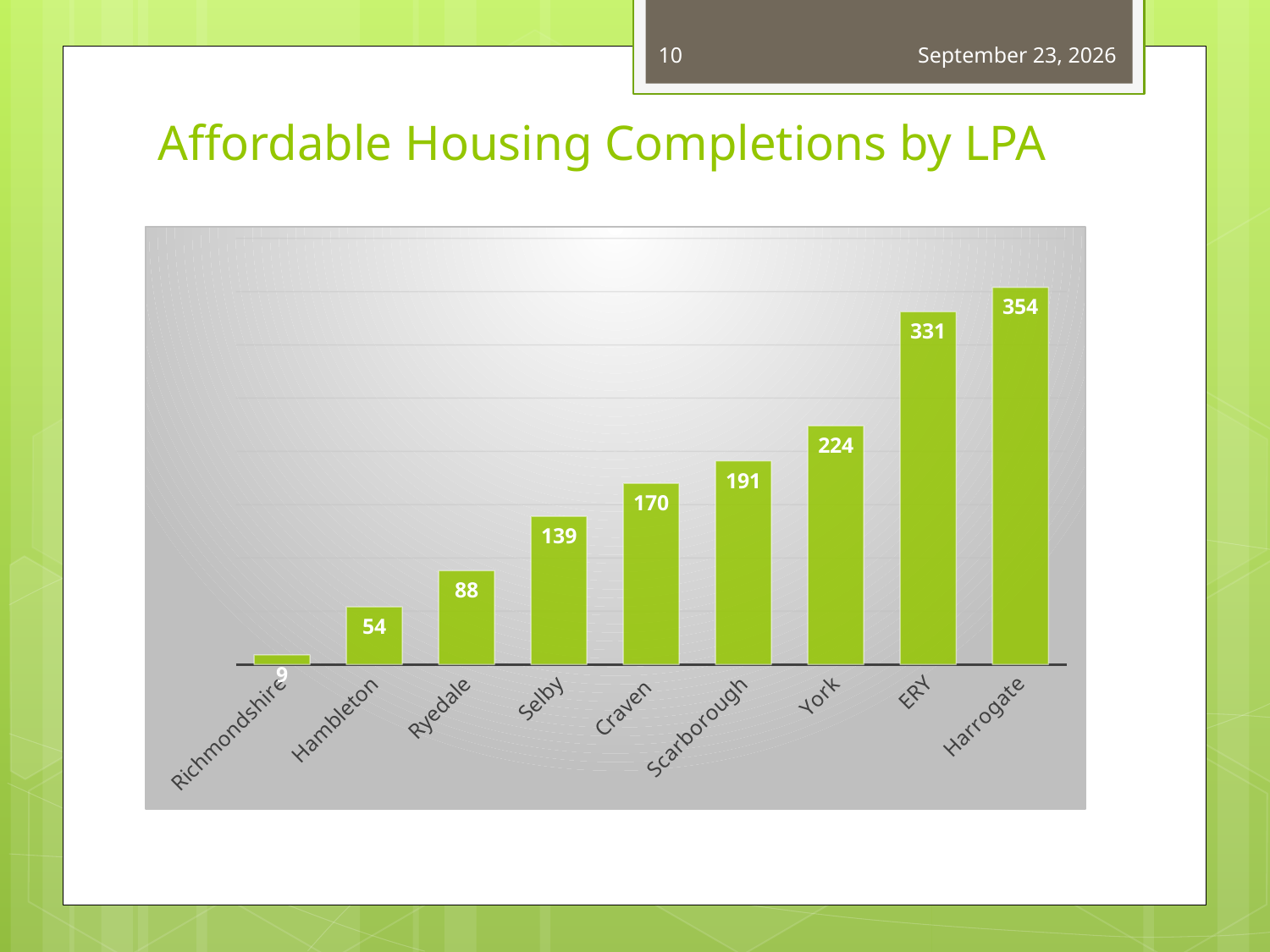
Do the values rise or fall from left to right along the x axis? Rise What kind of chart is shown on the slide? Bar chart What is the value for Selby? 139 Which LPA has the lowest number of affordable housing completions? Richmondshire Which is larger, the value for Ryedale or the value for Hambleton? Ryedale What is the title of the slide? Affordable Housing Completions by LPA How many LPAs are shown on the chart? 9 What is the value for York? 224 What is the value for Richmondshire? 9 Which LPA has the highest number of affordable housing completions? Harrogate What is the difference between the values for Harrogate and ERY? 23 What is the difference between the values for Scarborough and Craven? 21